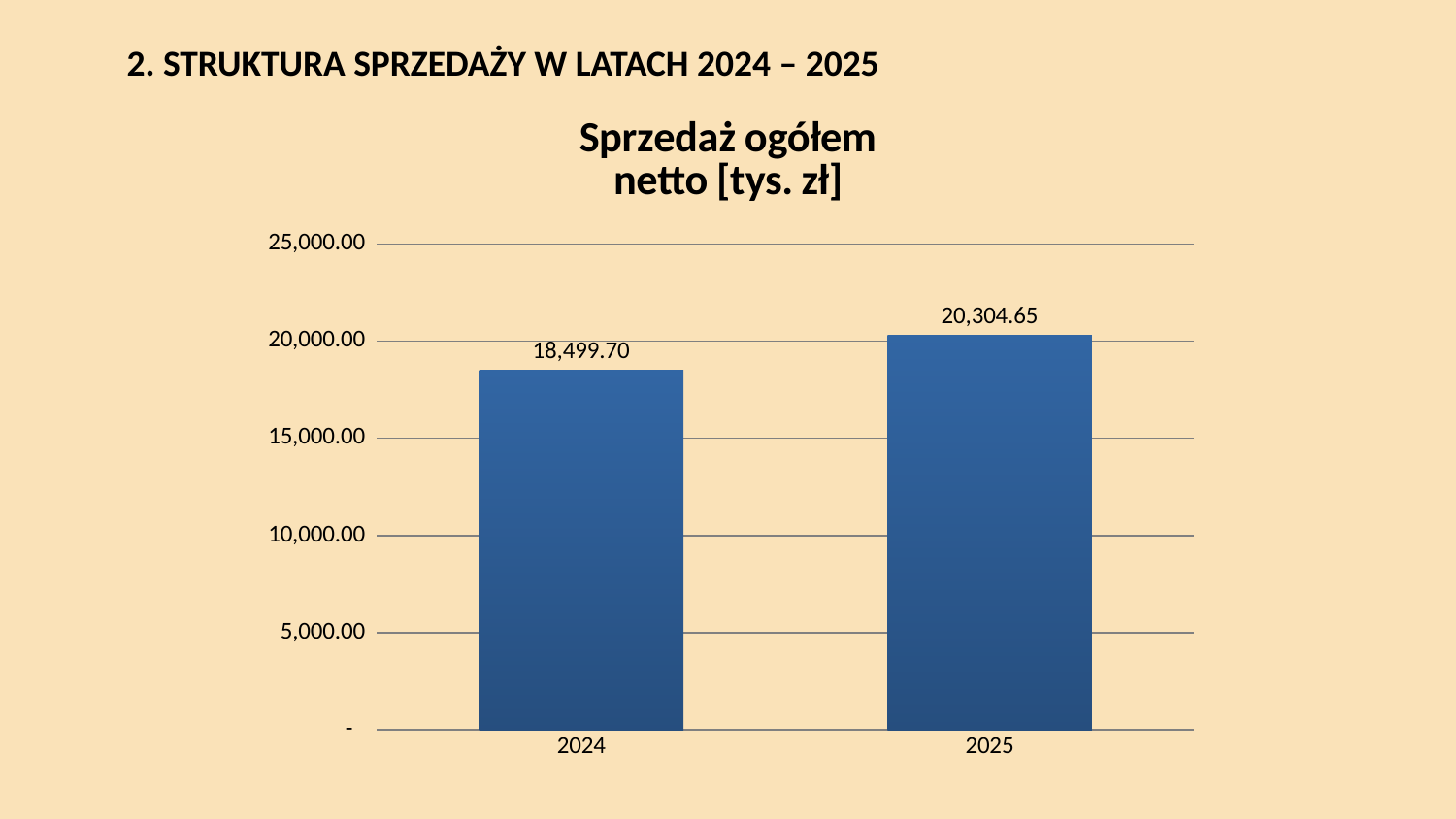
Which is larger, the value for 2024 or the value for 2025? 2025 What is the value for 2024? 18,499.70 What is the difference between the values for 2025 and 2024? 1,804.95 Which year has the lowest value? 2024 What is the value for 2025? 20,304.65 What is the title of the chart? Sprzedaż ogółem netto [tys. zł] How many categories are shown on the x axis? 2 Is the value for 2025 greater or less than 20,000.00? greater Is the value for 2024 greater or less than 20,000.00? less Which year has the highest value? 2025 What kind of chart is shown on the slide? bar chart Do the values rise or fall from 2024 to 2025? rise